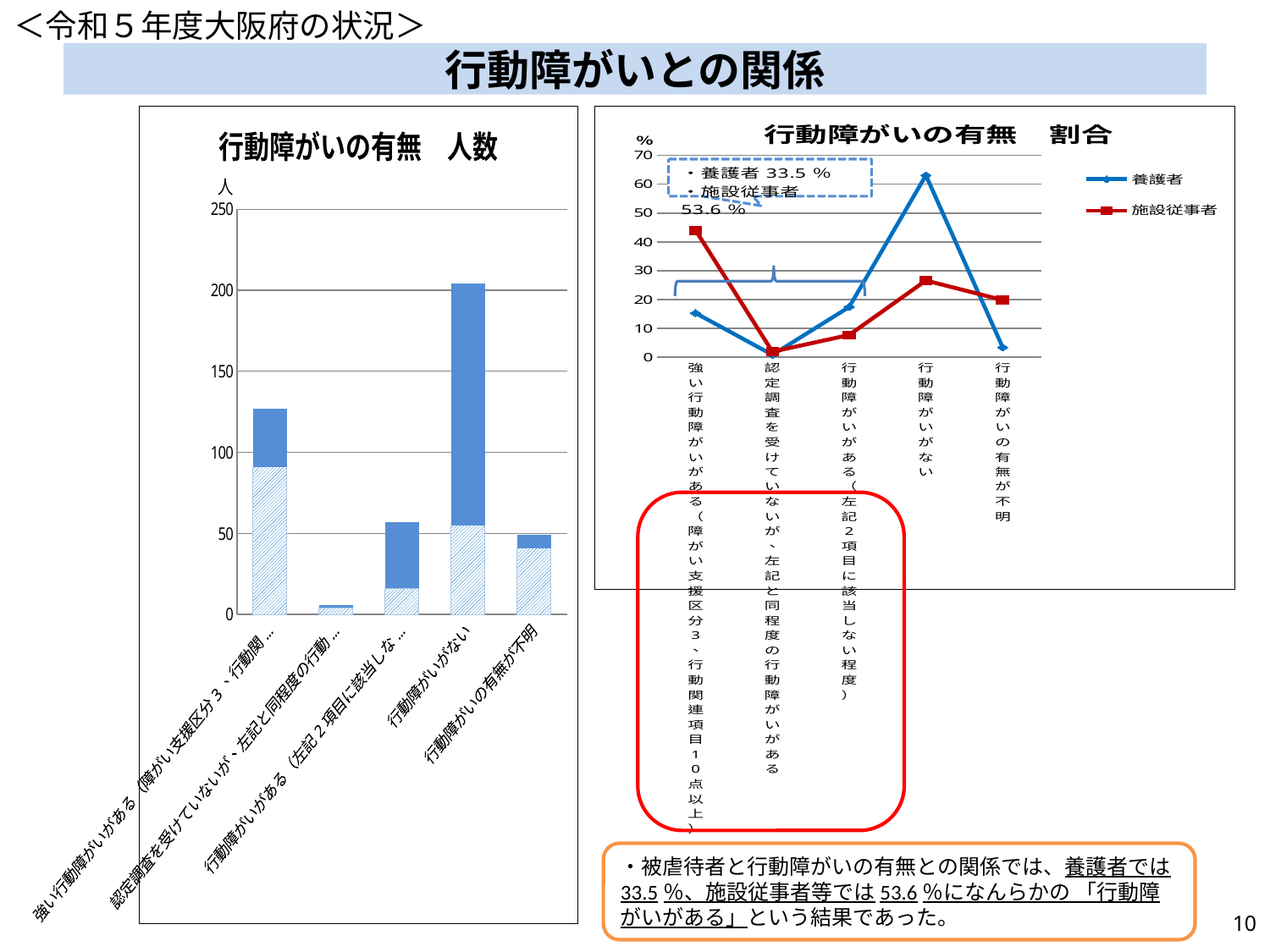
What kind of chart is the left chart titled 行動障がいの有無 人数? bar chart In the right chart 行動障がいの有無 割合, which category has the highest value for 養護者? 行動障がいがない In the right chart 行動障がいの有無 割合, which category has the lowest value for 施設従事者? 認定調査を受けていないが、左記と同程度の行動障がいがある In the left chart 行動障がいの有無 人数, how many categories are shown on the x axis? 5 What kind of chart is the right chart titled 行動障がいの有無 割合? line chart In the right chart 行動障がいの有無 割合, which category has the highest value for 施設従事者? 強い行動障がいがある In the left chart 行動障がいの有無 人数, which category has the tallest bar? 行動障がいがない In the left chart 行動障がいの有無 人数, is the total bar for 行動障がいがない greater or less than 200? greater In the left chart 行動障がいの有無 人数, is the total bar for 行動障がいの有無が不明 greater or less than 100? less In the right chart 行動障がいの有無 割合, how many series does the legend list? 2 In the right chart 行動障がいの有無 割合, is the 養護者 value for 行動障がいがない greater or less than 60? greater In the right chart 行動障がいの有無 割合, for 行動障がいがない, which series has the larger value, 養護者 or 施設従事者? 養護者